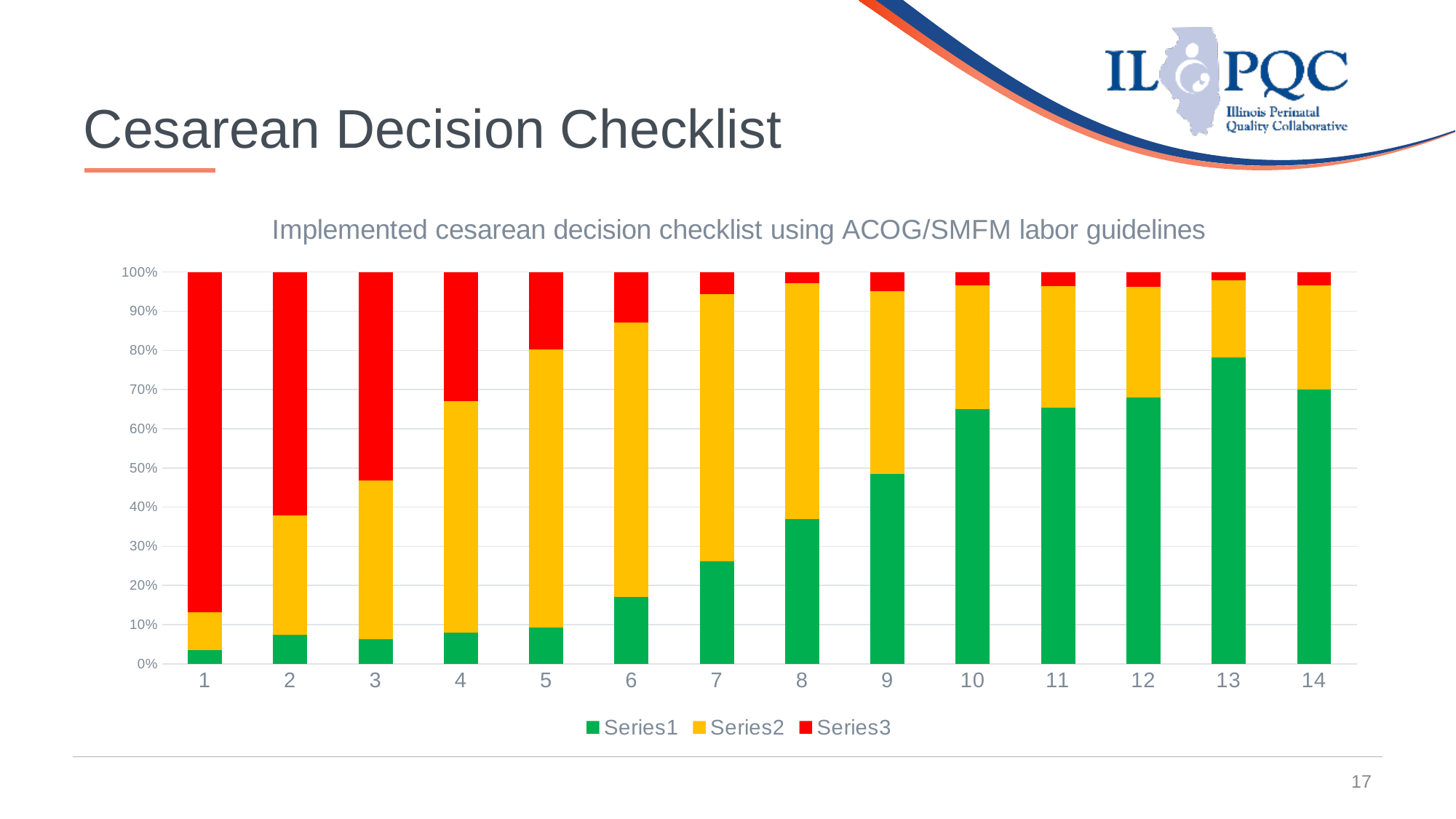
What is the title of the chart? Implemented cesarean decision checklist using ACOG/SMFM labor guidelines Which is larger, the Series1 value at category 7 or at category 8? Category 8 Is the value for Series1 at category 8 greater or less than 40%? less How many categories are shown along the x axis? 14 Does the Series1 value generally rise or fall from category 1 to category 14? Rise Which category has the highest value for Series3? 1 Which category has the lowest value for Series1? 1 How many series does the legend list? 3 Which category has the highest value for Series1? 13 Which colour represents Series1 in the chart? Green What kind of chart is shown on the slide? Stacked bar chart Is the value for Series1 at category 13 greater or less than 70%? greater